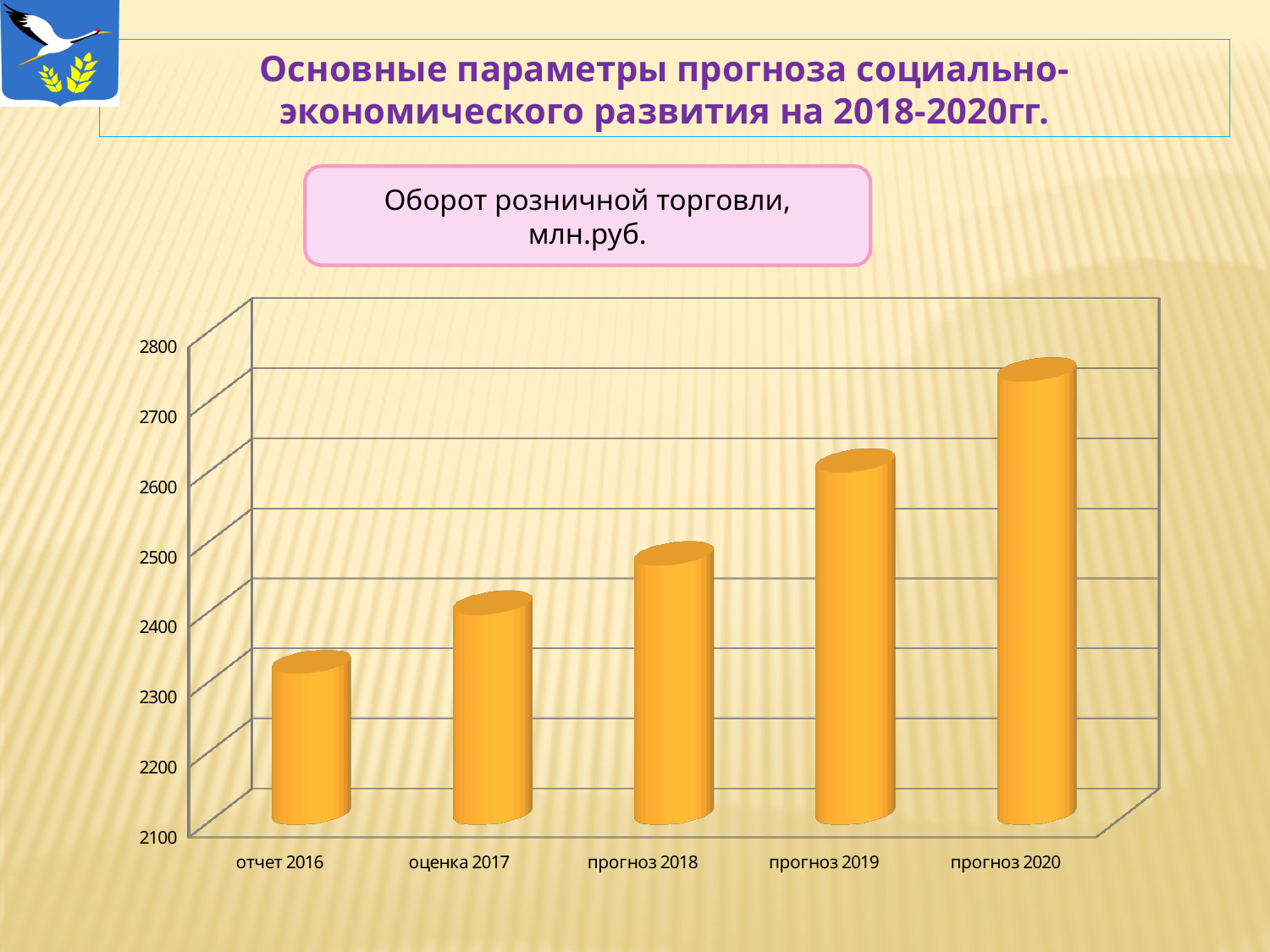
Is the value for прогноз 2018 greater or less than 2600? less Which category has the lowest value in the chart? отчет 2016 Is the value for отчет 2016 greater or less than 2200? greater Is the value for прогноз 2020 greater or less than 2600? greater Do the values rise or fall from отчет 2016 to прогноз 2020? rise Which is larger, the value for прогноз 2019 or the value for оценка 2017? прогноз 2019 What kind of chart is shown on the slide? bar chart How many categories are shown on the x axis of the chart? 5 What is the title of the chart shown on the slide? Оборот розничной торговли, млн.руб. Which category has the highest value in the chart? прогноз 2020